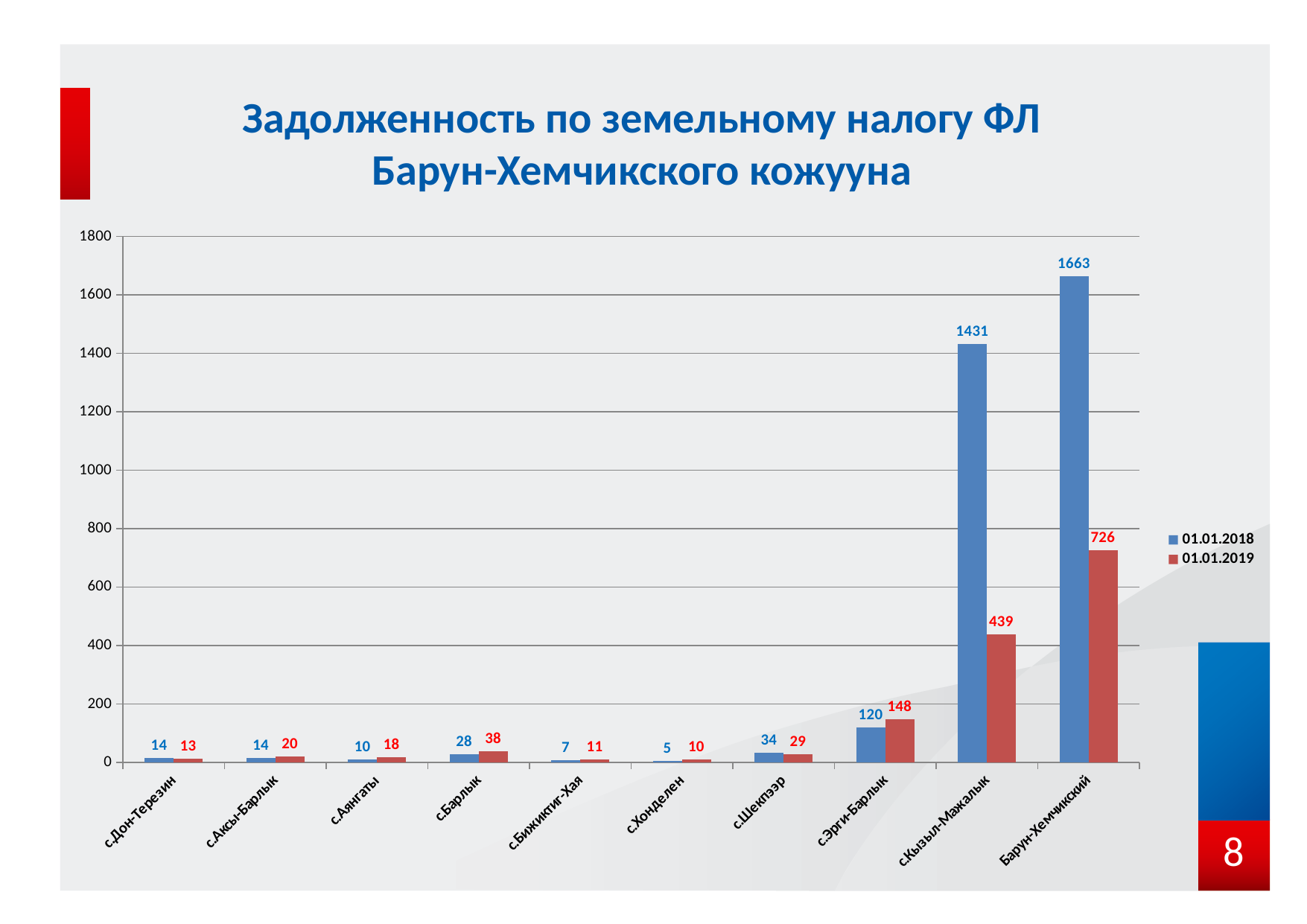
What is the value for с.Кызыл-Мажалык in the 01.01.2019 series? 439 What is the difference between the 01.01.2018 and 01.01.2019 values for с.Эрги-Барлык? 28 What kind of chart is shown on the slide? bar chart What is the value for Барун-Хемчикский in the 01.01.2018 series? 1663 Which category has the lowest value in the 01.01.2018 series? с.Хонделен How many categories are shown on the x axis? 10 How many series does the legend list? 2 Which is larger for с.Шекпээр: the 01.01.2018 value or the 01.01.2019 value? 01.01.2018 Which category has the highest value in the 01.01.2018 series? Барун-Хемчикский Is the 01.01.2019 value for с.Кызыл-Мажалык greater or less than 600? less What is the value for с.Барлык in the 01.01.2019 series? 38 What is the difference between the 01.01.2018 and 01.01.2019 values for Барун-Хемчикский? 937